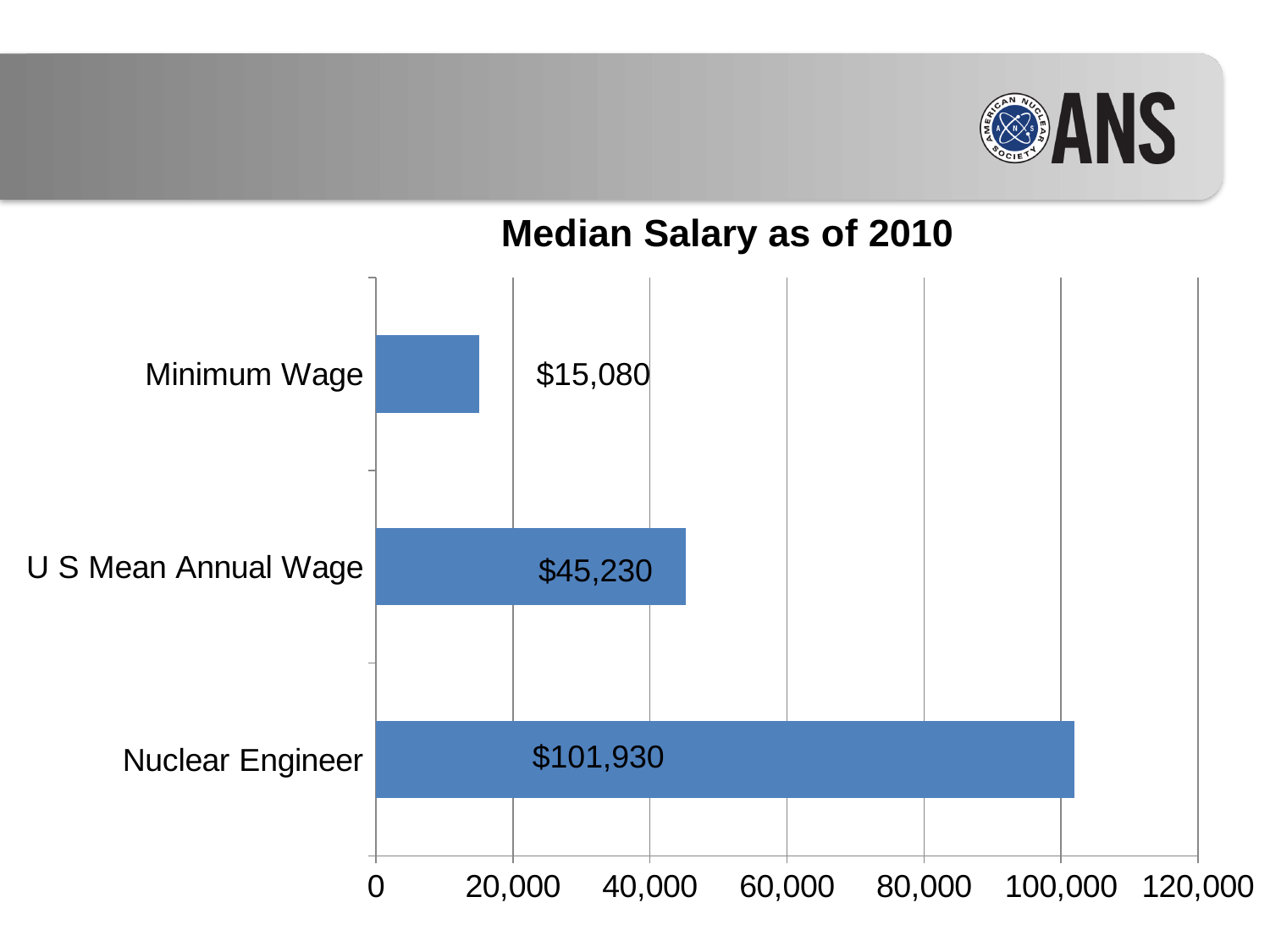
Which category has the highest value? Nuclear Engineer How many categories are shown in the chart? 3 What kind of chart is shown on the slide? Bar chart What is the value shown for Minimum Wage? $15,080 What is the value shown for U S Mean Annual Wage? $45,230 Which is larger, the value for U S Mean Annual Wage or the value for Minimum Wage? U S Mean Annual Wage What is the median salary shown for Nuclear Engineer? $101,930 Which category has the lowest value? Minimum Wage What is the difference between the Nuclear Engineer value and the U S Mean Annual Wage value? $56,700 What is the title of the chart? Median Salary as of 2010 What is the difference between the U S Mean Annual Wage value and the Minimum Wage value? $30,150 Is the value for Nuclear Engineer greater or less than 100,000? greater